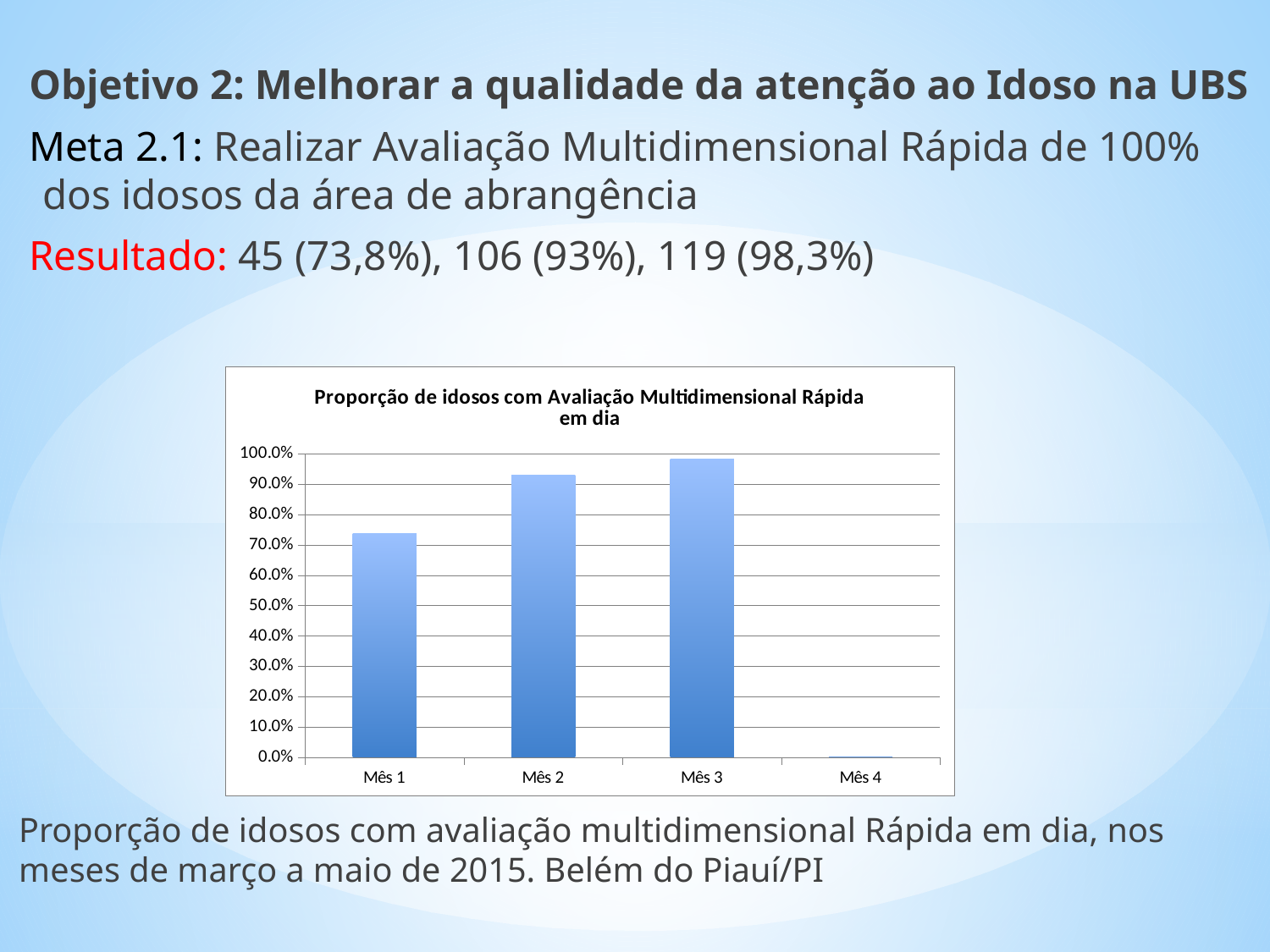
Which month has the highest bar in the chart? Mês 3 Is the value for Mês 2 greater or less than 90.0%? greater Is the value for Mês 3 greater or less than 90.0%? greater What kind of chart is shown on the slide? bar chart Which month has the lowest bar in the chart? Mês 4 Which is larger, the value for Mês 1 or the value for Mês 2? Mês 2 Is the value for Mês 1 greater or less than 70.0%? greater How many categories are shown on the x axis of the chart? 4 What is the title of the chart? Proporção de idosos com Avaliação Multidimensional Rápida em dia Do the values rise or fall from Mês 1 to Mês 3? rise